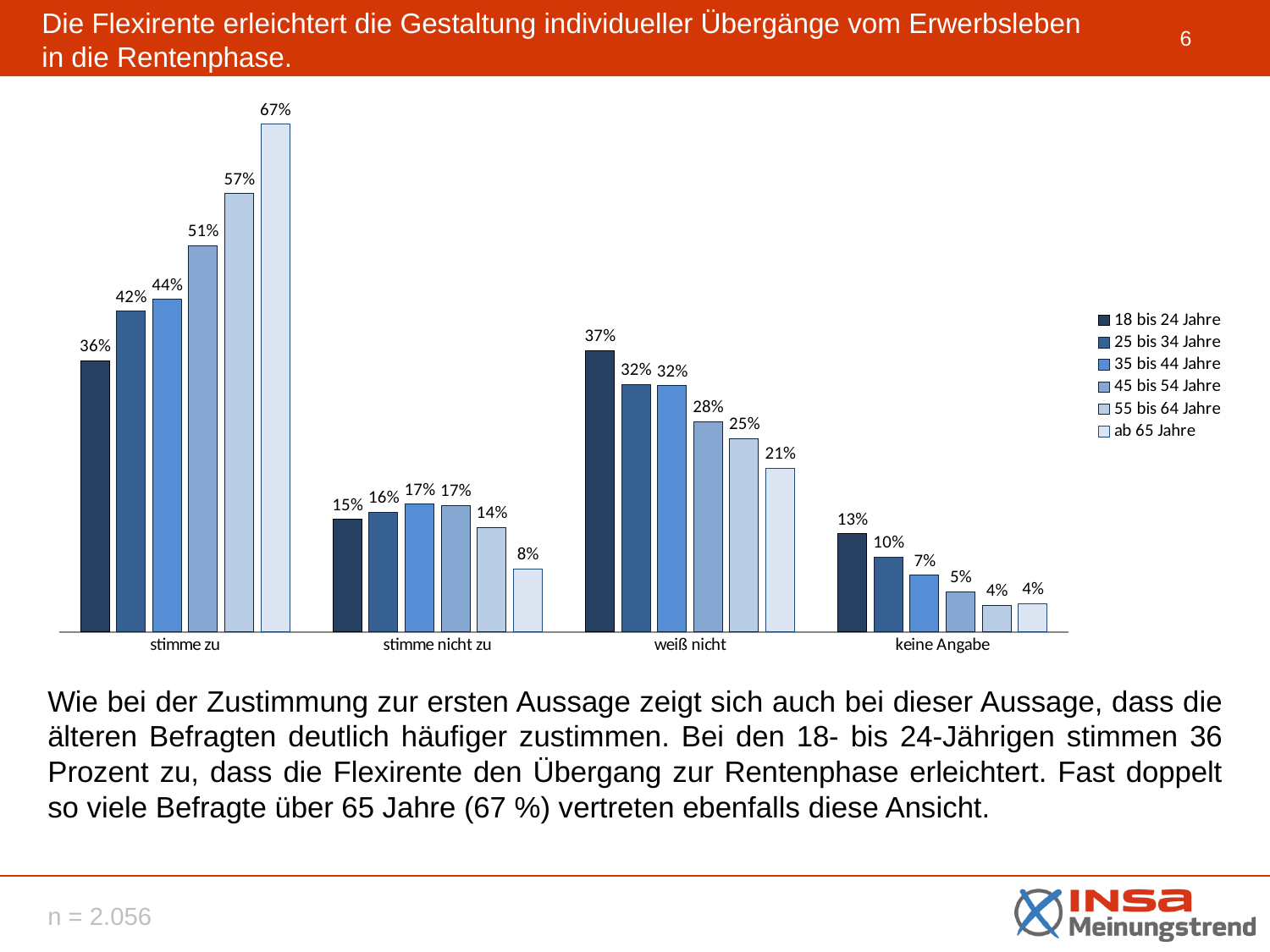
What is the sample size (n) stated on the slide? n = 2.056 Which age group has the lowest value in the "stimme nicht zu" category? ab 65 Jahre Which age group has the highest value in the "stimme zu" category? ab 65 Jahre How many response categories are shown on the x axis? 4 What is the value for "18 bis 24 Jahre" in the "weiß nicht" category? 37% What is the value for "55 bis 64 Jahre" in the "stimme nicht zu" category? 14% What kind of chart is shown on the slide? Bar chart What is the value for "ab 65 Jahre" in the "stimme zu" category? 67% In the "keine Angabe" category, which is larger: the value for "18 bis 24 Jahre" or for "25 bis 34 Jahre"? 18 bis 24 Jahre In the "weiß nicht" category, do the values rise or fall from the youngest to the oldest age group? Fall What is the difference between the "ab 65 Jahre" and "18 bis 24 Jahre" values in the "stimme zu" category? 31 percentage points How many series does the legend list? 6